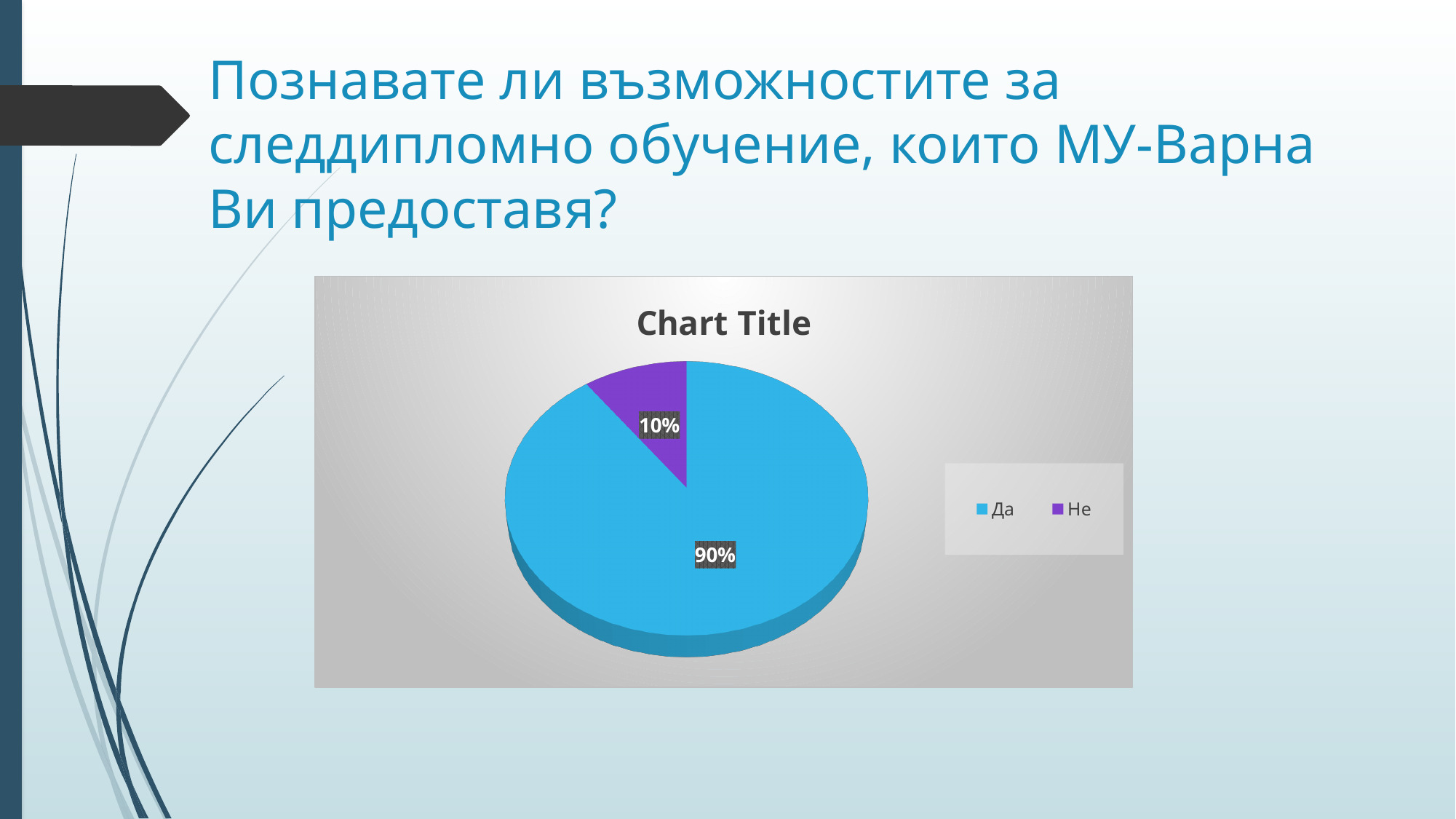
What share of the pie does the "Да" slice represent? 90% How many entries does the legend list? 2 What is the difference in percentage points between the "Да" and "Не" slices? 80 Which slice of the pie is the largest? Да Which is larger, the "Да" slice or the "Не" slice? Да Which slice of the pie is the smallest? Не What is the title shown above the pie chart? Chart Title What colour is the "Не" slice of the pie? purple What kind of chart is shown on the slide? pie chart What share of the pie does the "Не" slice represent? 10% How many slices does the pie chart have? 2